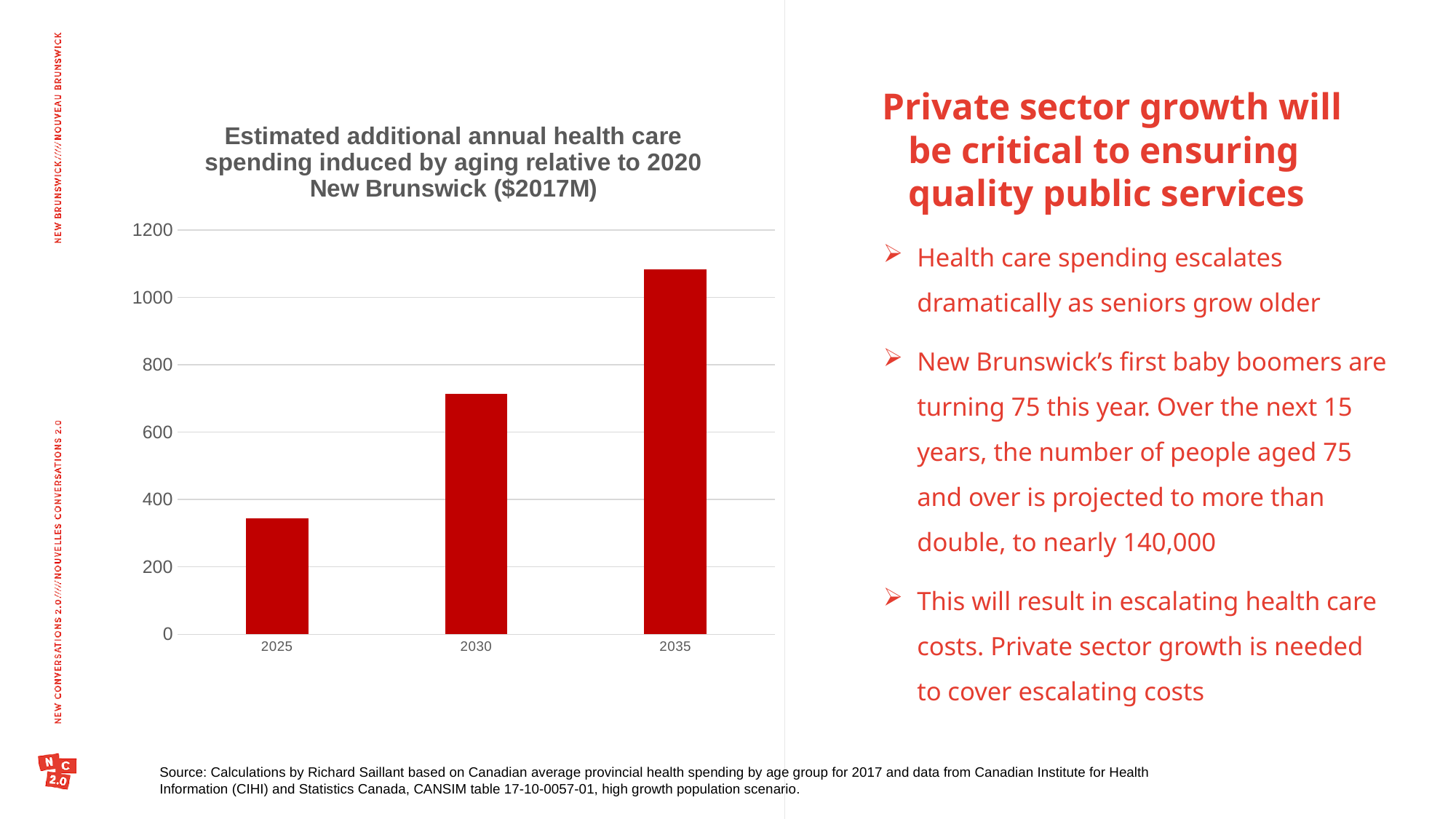
Which year has the highest estimated additional annual health care spending? 2035 What kind of chart is shown on the slide? bar chart How many years are plotted on the chart? 3 Is the value for 2025 greater or less than 200? greater Is the value for 2035 greater or less than 1000? greater Is the value for 2030 greater or less than 800? less Do the values rise or fall from 2025 to 2035? rise Which is larger, the value for 2030 or the value for 2035? 2035 Which year has the lowest estimated additional annual health care spending? 2025 What is the title of the chart? Estimated additional annual health care spending induced by aging relative to 2020 New Brunswick ($2017M)